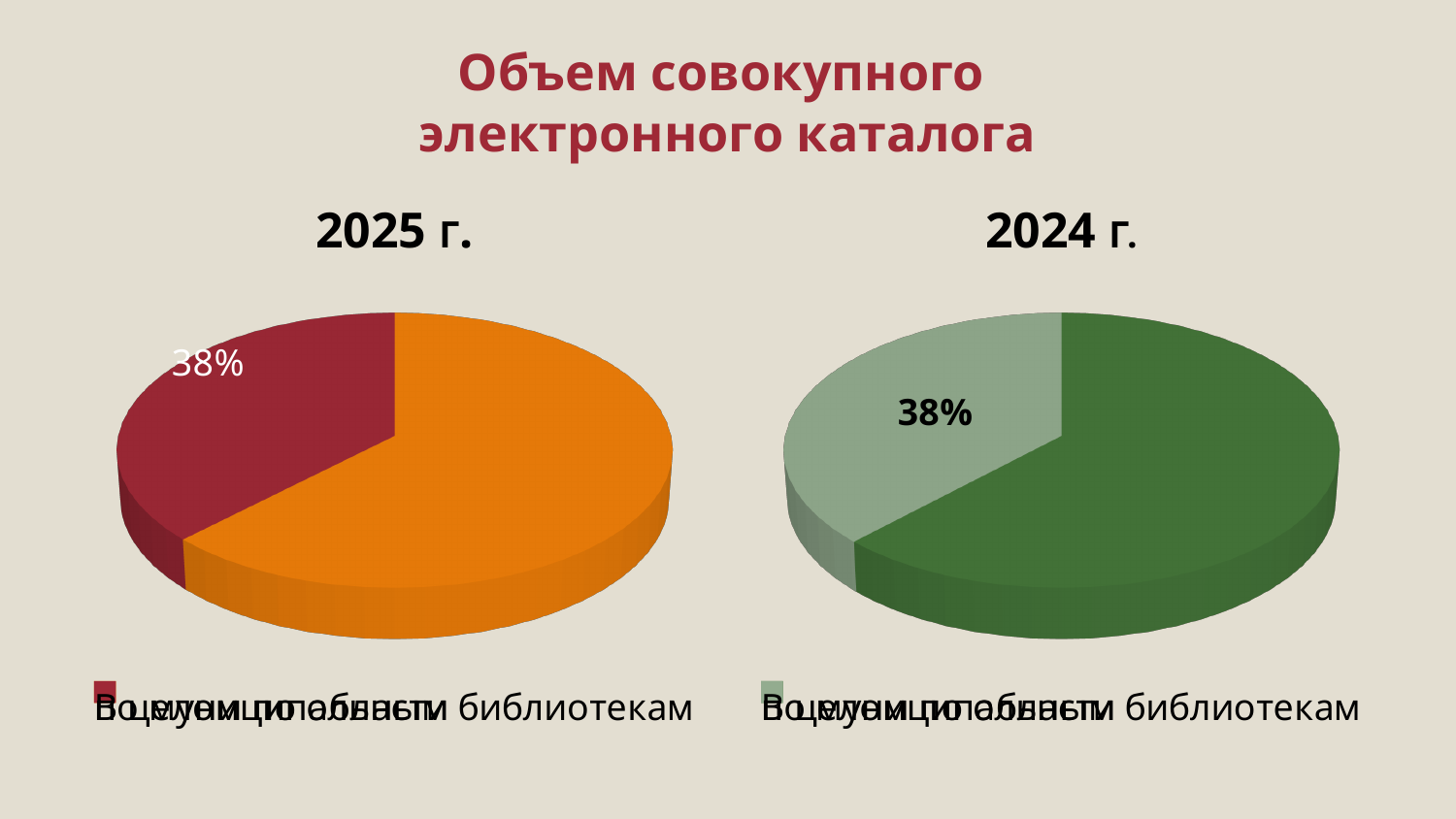
What is the title of the slide above the two pie charts? Объем совокупного электронного каталога How many pie charts are on the slide? 2 How many slices does the 2024 г. pie chart have? 2 Which two years are shown as chart titles on the slide? 2025 г. and 2024 г. Is the labelled slice in the 2025 г. chart larger, smaller, or the same as the labelled slice in the 2024 г. chart? the same In the 2025 г. chart, what percentage is printed on the dark red slice? 38% What kind of chart is the 2024 г. chart? pie chart How many slices does the 2025 г. pie chart have? 2 In the 2024 г. chart, which slice is larger, the dark green one or the light green one? the dark green one What kind of chart is the 2025 г. chart? pie chart In the 2025 г. chart, which slice is larger, the orange one or the dark red one? the orange one In the 2024 г. chart, what percentage is printed on the light green slice? 38%